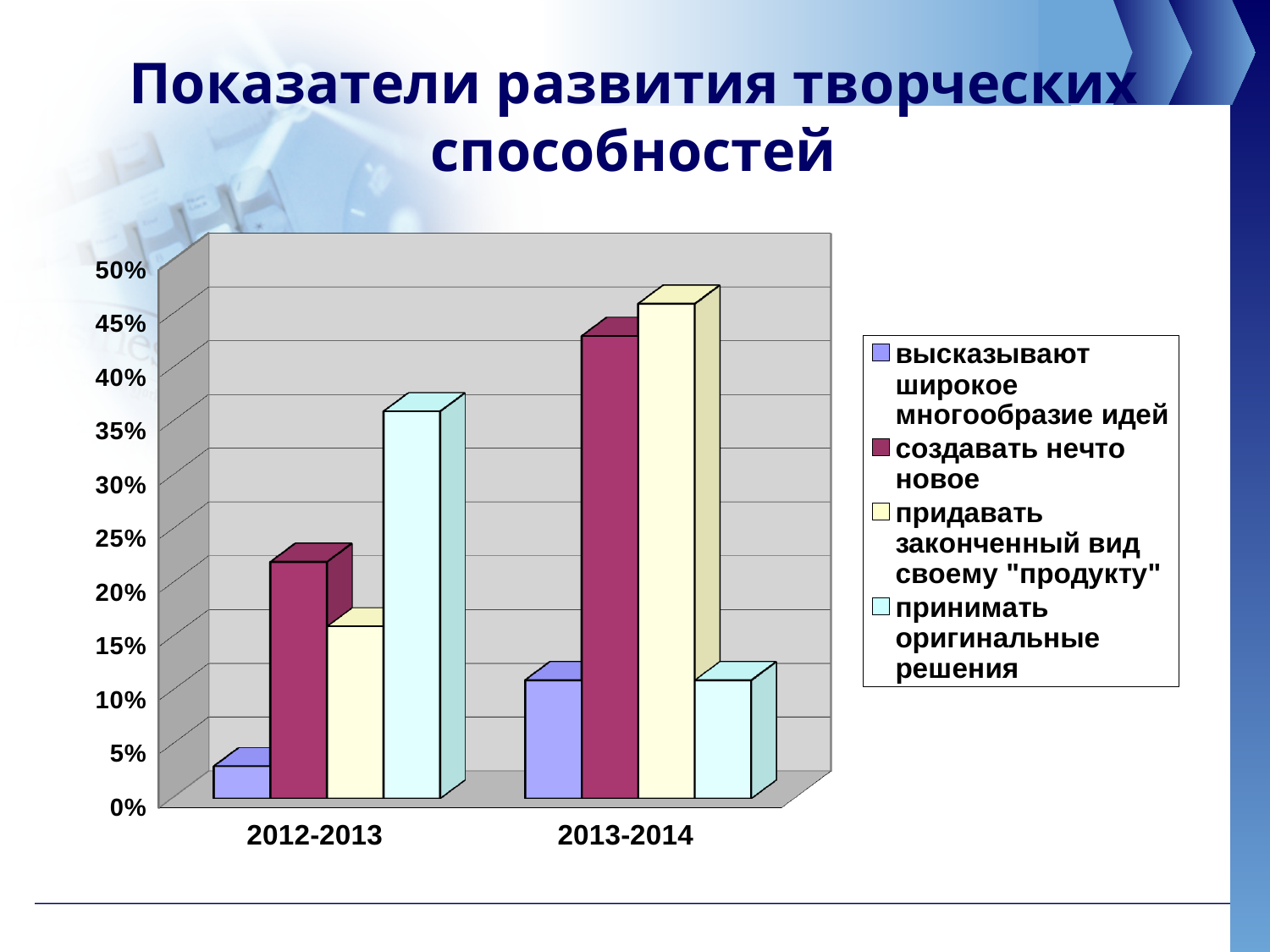
Is the value for "высказывают широкое многообразие идей" in 2012-2013 greater or less than 5%? less Does the value for "принимать оригинальные решения" rise or fall from 2012-2013 to 2013-2014? fall Which series has the highest value for 2013-2014? придавать законченный вид своему "продукту" How many series does the legend list? 4 Which series has the lowest value for 2012-2013? высказывают широкое многообразие идей Is the value for "принимать оригинальные решения" in 2012-2013 greater or less than 30%? greater How many categories are shown on the x axis? 2 Which series has the highest value for 2012-2013? принимать оригинальные решения Is the value for "создавать нечто новое" in 2013-2014 greater or less than 40%? greater What is the title of the slide containing the chart? Показатели развития творческих способностей What kind of chart is shown on the slide? bar chart Which is larger for "создавать нечто новое": the value for 2012-2013 or for 2013-2014? 2013-2014